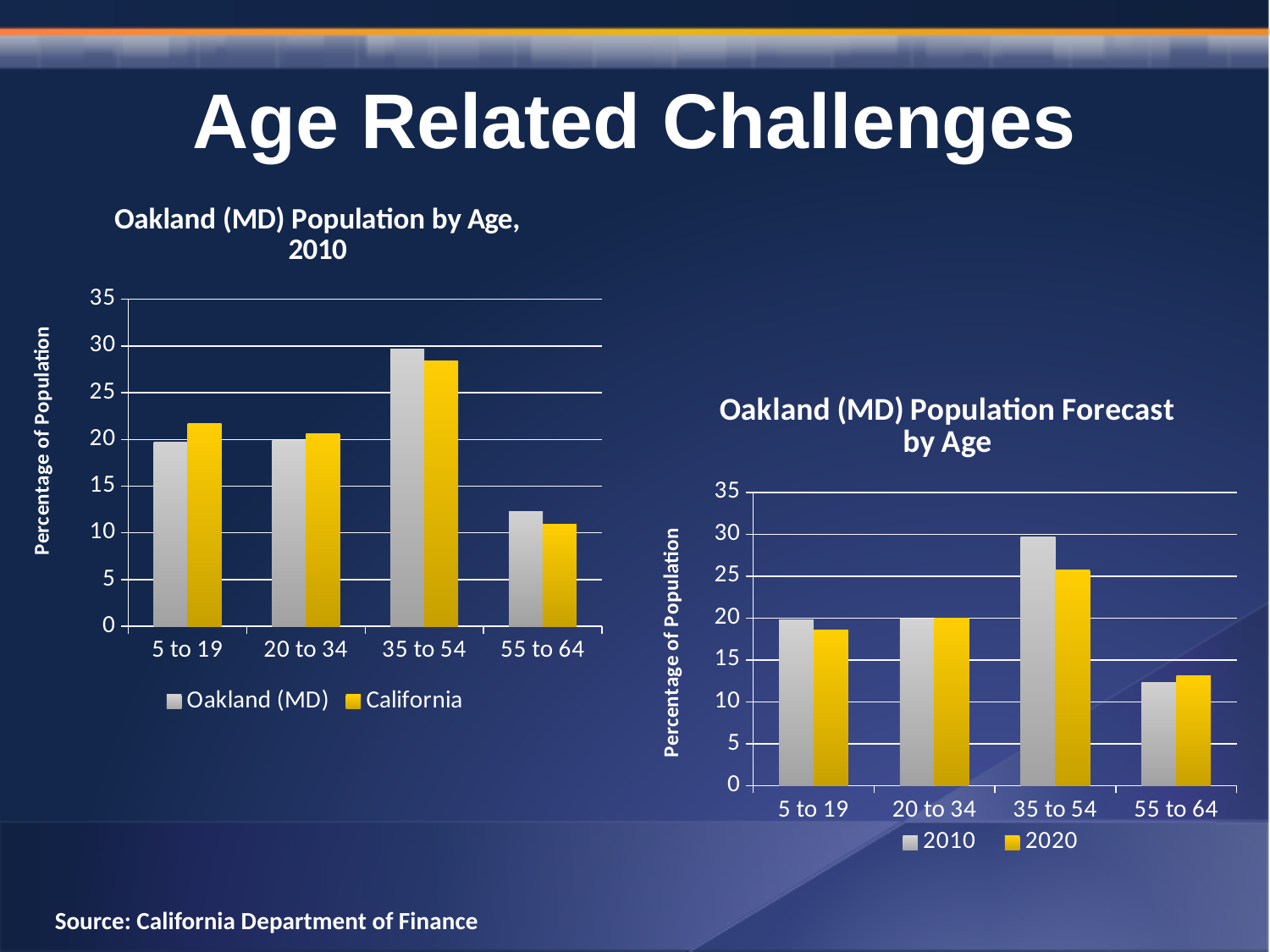
In the 'Oakland (MD) Population by Age, 2010' chart, how many age categories are shown on the x axis? 4 In the 'Oakland (MD) Population by Age, 2010' chart, for the 5 to 19 age group, which is larger: Oakland (MD) or California? California In the 'Oakland (MD) Population Forecast by Age' chart, which age group has the highest value for 2020? 35 to 54 In the 'Oakland (MD) Population by Age, 2010' chart, which age group has the lowest value for California? 55 to 64 In the 'Oakland (MD) Population by Age, 2010' chart, how many series does the legend list? 2 In the 'Oakland (MD) Population by Age, 2010' chart, which age group has the highest value for Oakland (MD)? 35 to 54 In the 'Oakland (MD) Population Forecast by Age' chart, is the 2020 value for 55 to 64 greater or less than 15? less In the 'Oakland (MD) Population by Age, 2010' chart, is the Oakland (MD) value for 35 to 54 greater or less than 25? greater In the 'Oakland (MD) Population Forecast by Age' chart, what are the two series listed in the legend? 2010 and 2020 In the 'Oakland (MD) Population Forecast by Age' chart, for the 35 to 54 age group, which is larger: 2010 or 2020? 2010 In the 'Oakland (MD) Population Forecast by Age' chart, which age group has the lowest value for 2010? 55 to 64 What kind of chart is the 'Oakland (MD) Population by Age, 2010' chart on the left? bar chart